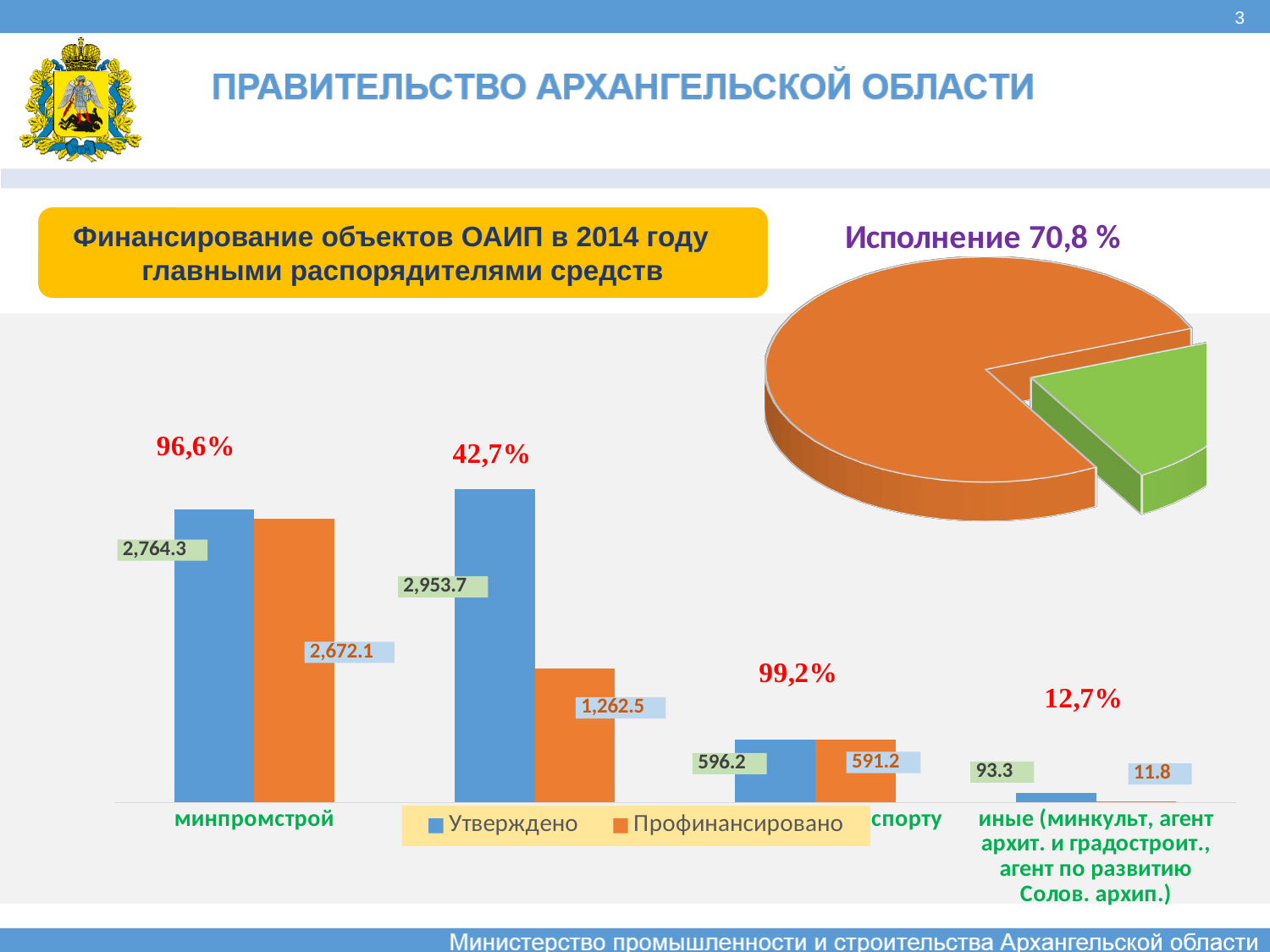
In the bar chart, what is the Утверждено value for минпромстрой? 2,764.3 What percentage is shown above the bars for минпромстрой? 96,6% In the bar chart, which category has the highest Утверждено value? the second category from the left (2,953.7) In the bar chart, what is the difference between the Утверждено and Профинансировано values for минпромстрой? 92.2 In the bar chart, what is the Утверждено value for the second category from the left? 2,953.7 How many series does the bar chart legend list? 2 In the bar chart, what is the Профинансировано value for минпромстрой? 2,672.1 What type of chart is shown in the upper right of the slide under the heading Исполнение 70,8 %? pie chart In the bar chart, which is larger for минпромстрой: Утверждено or Профинансировано? Утверждено In the bar chart, which category has the lowest Профинансировано value? иные (минкульт, агент архит. и градостроит., агент по развитию Солов. архип.) In the bar chart, what is the difference between the Утверждено and Профинансировано values for the second category from the left? 1,691.2 In the bar chart, what is the Профинансировано value for the category иные (минкульт, агент архит. и градостроит., агент по развитию Солов. архип.)? 11.8